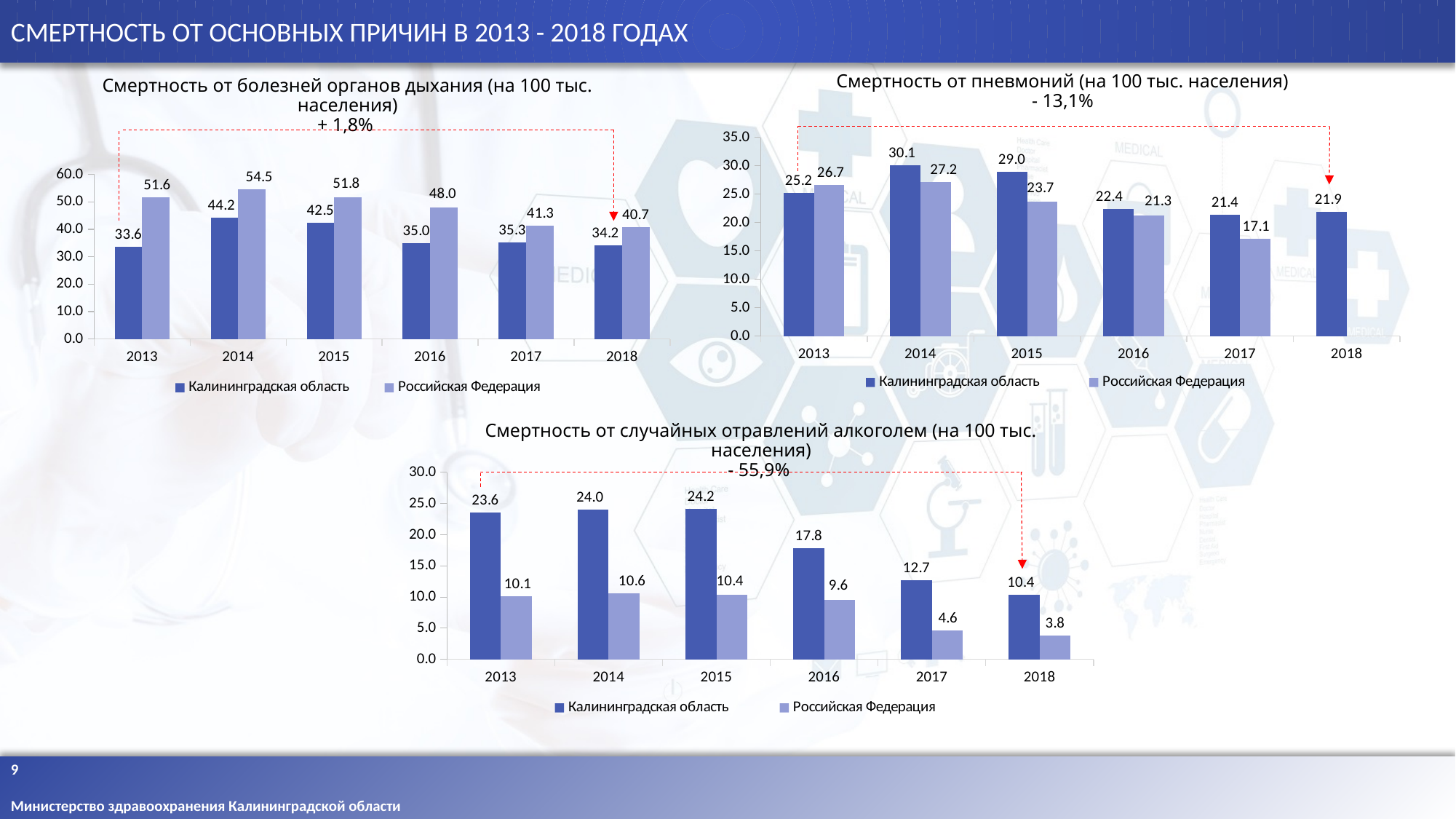
In the chart 'Смертность от болезней органов дыхания', what is the value for Российская Федерация in 2018? 40.7 How many series does the legend of the chart 'Смертность от пневмоний' list? 2 In the chart 'Смертность от случайных отравлений алкоголем', which year has the highest value for Калининградская область? 2015 In the chart 'Смертность от болезней органов дыхания', what is the value for Калининградская область in 2014? 44.2 In the chart 'Смертность от случайных отравлений алкоголем', what is the value for Российская Федерация in 2017? 4.6 In the chart 'Смертность от пневмоний', which year has the lowest value for Российская Федерация? 2017 In the chart 'Смертность от пневмоний', what is the value for Калининградская область in 2015? 29.0 In the chart 'Смертность от пневмоний', which is larger in 2013: Калининградская область or Российская Федерация? Российская Федерация In the chart 'Смертность от случайных отравлений алкоголем', what is the difference between Калининградская область and Российская Федерация in 2018? 6.6 In the chart 'Смертность от болезней органов дыхания', which year has the highest value for Российская Федерация? 2014 In the chart 'Смертность от случайных отравлений алкоголем', does the value for Калининградская область rise or fall from 2015 to 2018? fall In the chart 'Смертность от болезней органов дыхания', what is the difference between Российская Федерация and Калининградская область in 2013? 18.0